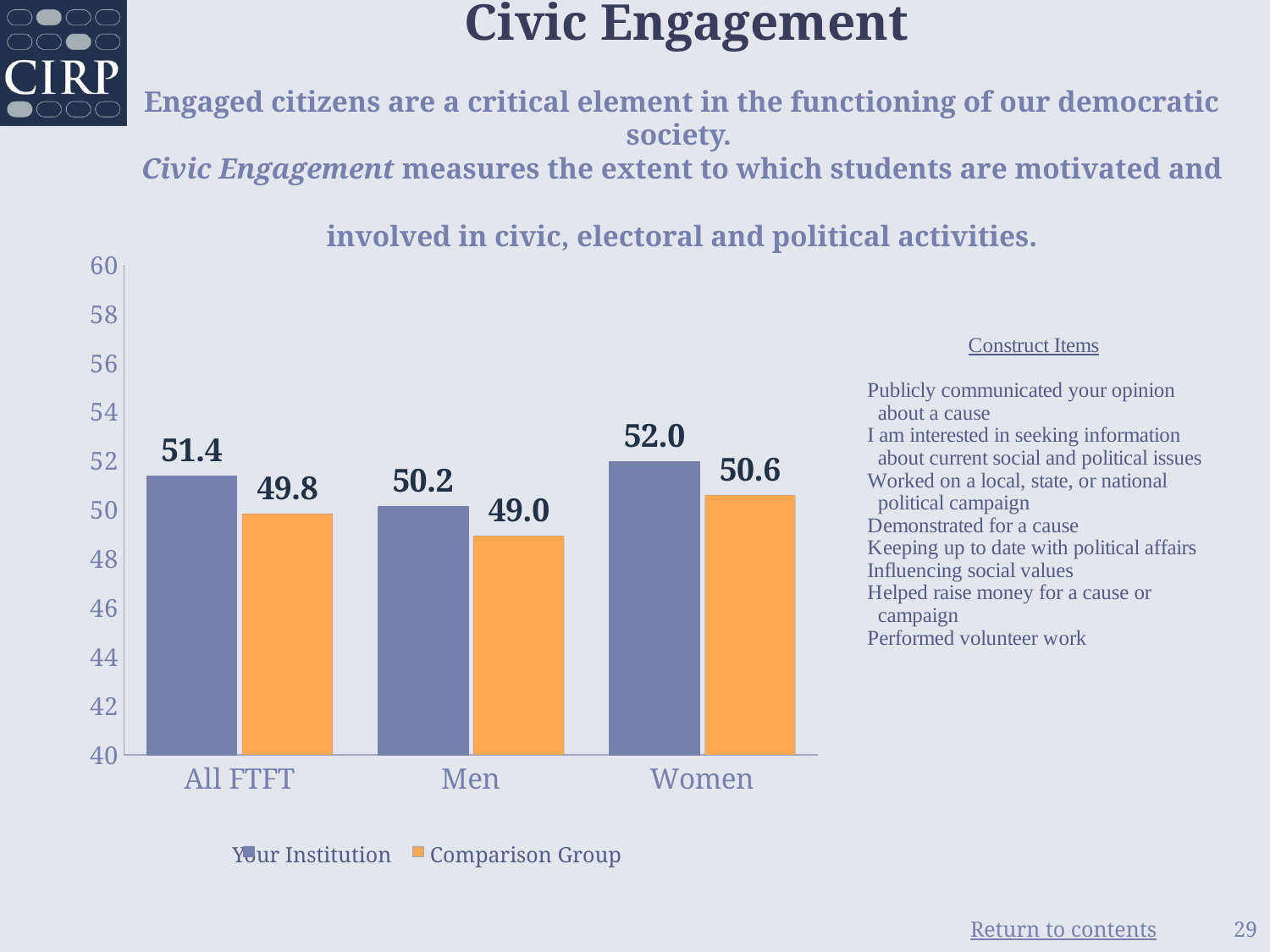
How many categories are shown on the x axis? 3 What is the Your Institution value for Women? 52.0 Which category has the lowest Your Institution value? Men What kind of chart is shown on the slide? Bar chart What is the difference between the Your Institution values for Women and Men? 1.8 What is the Comparison Group value for Men? 49.0 Which is larger for Men: Your Institution or Comparison Group? Your Institution Which category has the highest Comparison Group value? Women What is the Your Institution value for All FTFT? 51.4 How many series does the legend list? 2 Is the Comparison Group value for Women greater or less than 50? greater What is the difference between the Your Institution and Comparison Group values for All FTFT? 1.6